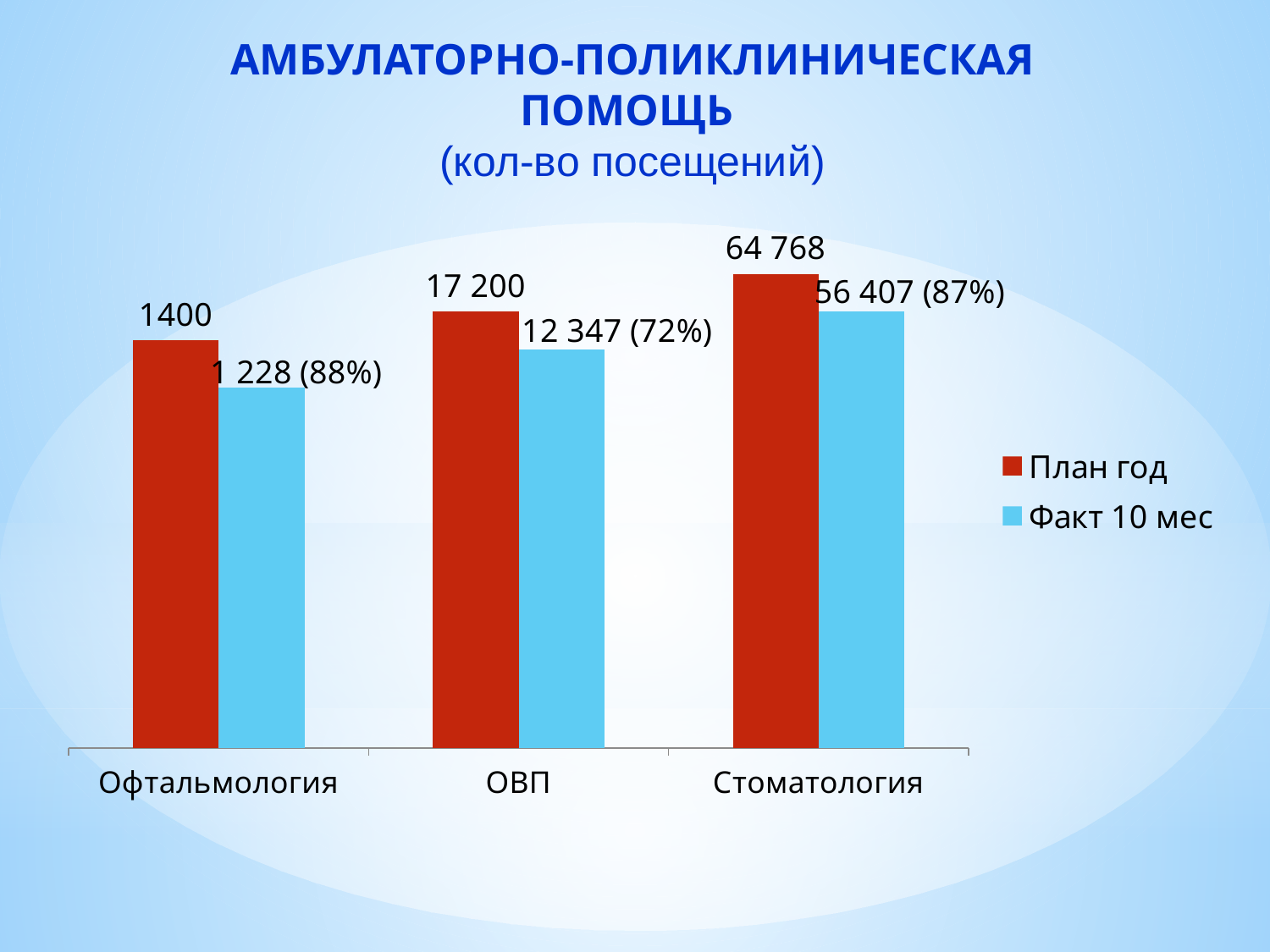
What percentage of the plan is shown for Офтальмология in the Факт 10 мес series? 88% What is the difference between План год and Факт 10 мес for ОВП? 4 853 What is the План год value for Офтальмология? 1400 How many categories are shown on the x axis? 3 Which category has the lowest Факт 10 мес value? Офтальмология What is the Факт 10 мес value for Стоматология? 56 407 (87%) Which series is shown in red? План год How many series does the legend list? 2 What kind of chart is shown on the slide? bar chart What is the Факт 10 мес value for ОВП? 12 347 (72%) What is the План год value for Стоматология? 64 768 Which category has the highest План год value? Стоматология